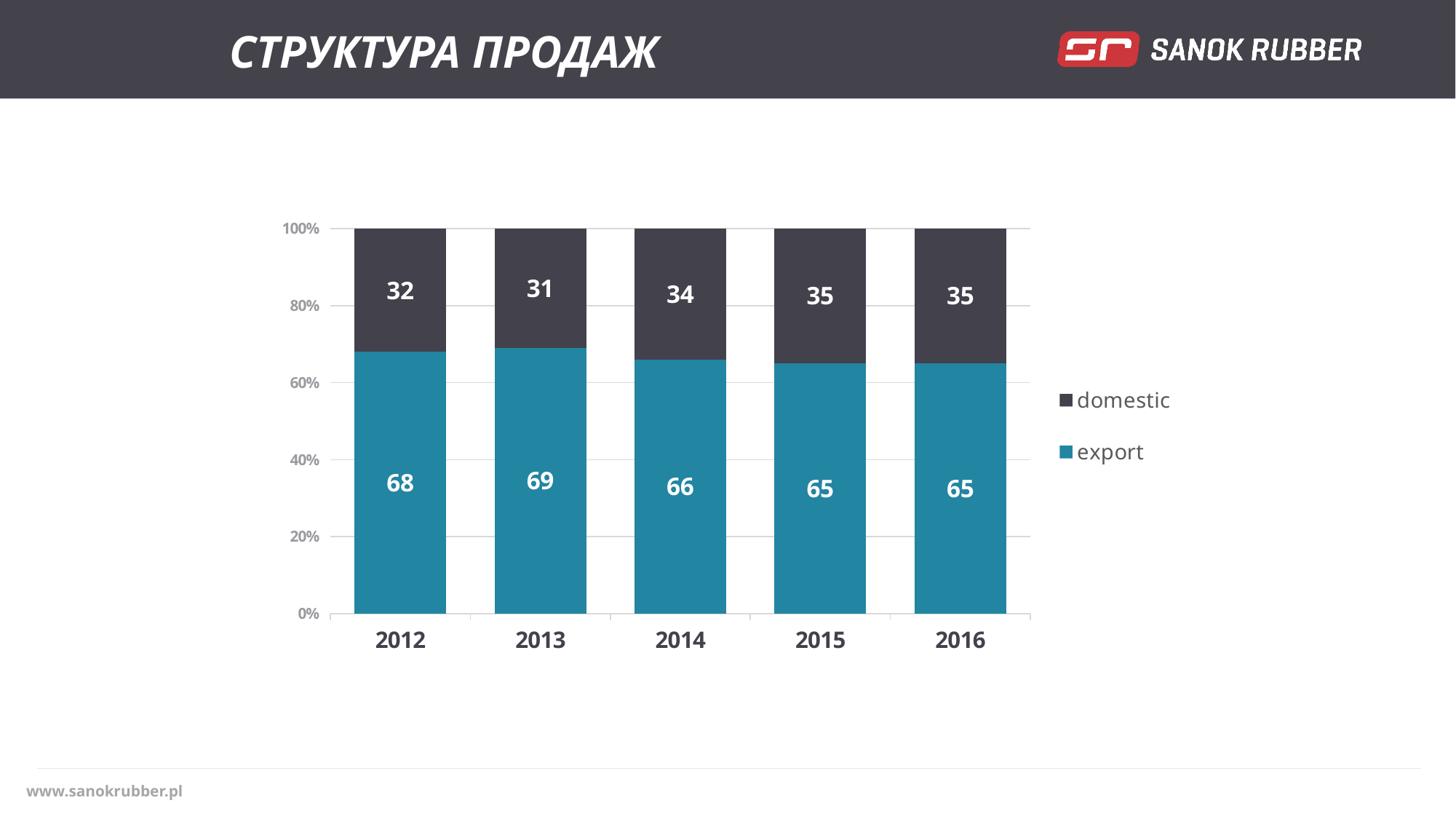
Which year has the highest export value? 2013 How many series does the legend list? 2 What is the export value for 2016? 65 Does the domestic value rise or fall from 2013 to 2016? rise What kind of chart is shown on the slide? stacked bar chart What is the export value for 2013? 69 Which year has the lowest domestic value? 2013 How many years are shown on the x axis? 5 Which series is shown in teal? export What is the difference between the export and domestic values in 2012? 36 What is the domestic value for 2014? 34 Which is larger in 2015, the export value or the domestic value? export